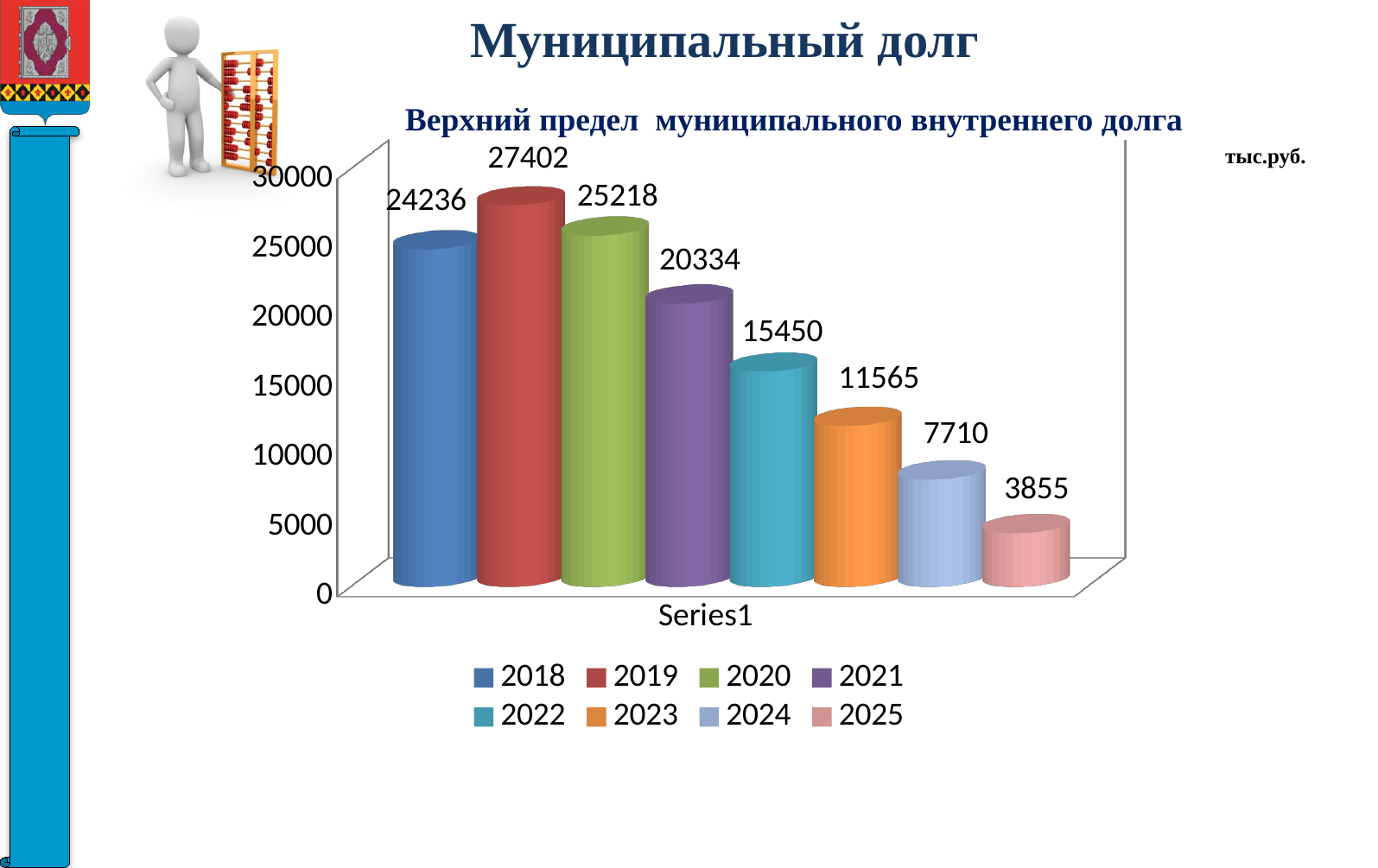
What is the value for 2019? 27402 What kind of chart is shown? bar chart What is the difference between the values for 2019 and 2018? 3166 How many series does the legend list? 8 What is the difference between the values for 2021 and 2022? 4884 Is the value for 2023 greater or less than 10000? greater What is the value for 2025? 3855 Which year has the highest value? 2019 Which is larger, the value for 2020 or the value for 2018? 2020 What unit is indicated next to the chart? тыс.руб. What is the value for 2022? 15450 Which year has the lowest value? 2025